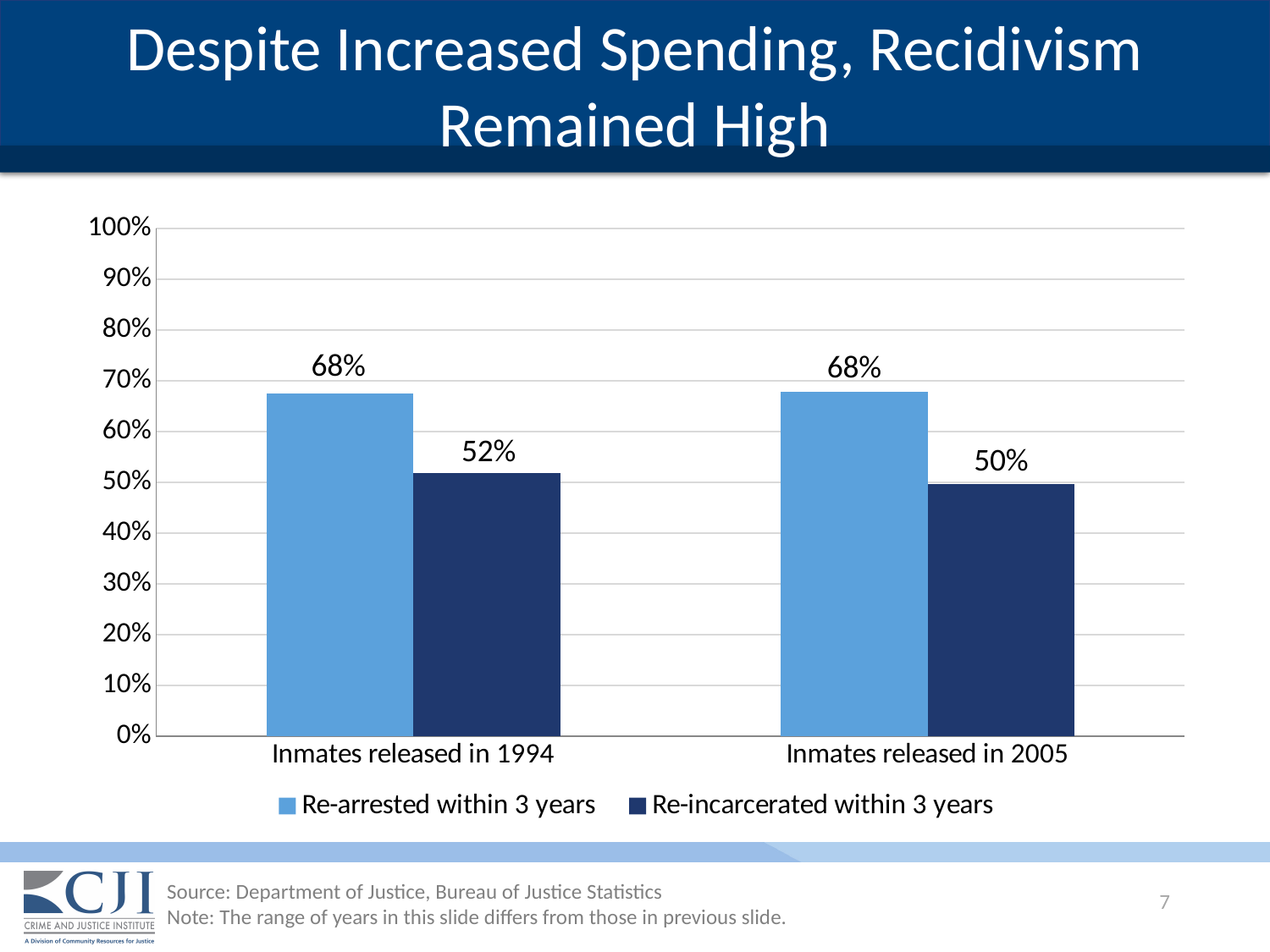
What is the title of the slide? Despite Increased Spending, Recidivism Remained High What percentage of inmates released in 1994 were re-incarcerated within 3 years? 52% Which is larger: the re-incarcerated rate for inmates released in 1994 or for inmates released in 2005? Inmates released in 1994 What is the difference between the re-arrested and re-incarcerated rates for inmates released in 1994? 16% What kind of chart is shown on the slide? Bar chart What percentage of inmates released in 1994 were re-arrested within 3 years? 68% What is the difference between the re-arrested and re-incarcerated rates for inmates released in 2005? 18% How many categories are shown on the x axis? 2 What percentage of inmates released in 2005 were re-arrested within 3 years? 68% Is the re-incarcerated within 3 years value for inmates released in 2005 greater or less than 60%? less What percentage of inmates released in 2005 were re-incarcerated within 3 years? 50% How many series does the legend list? 2